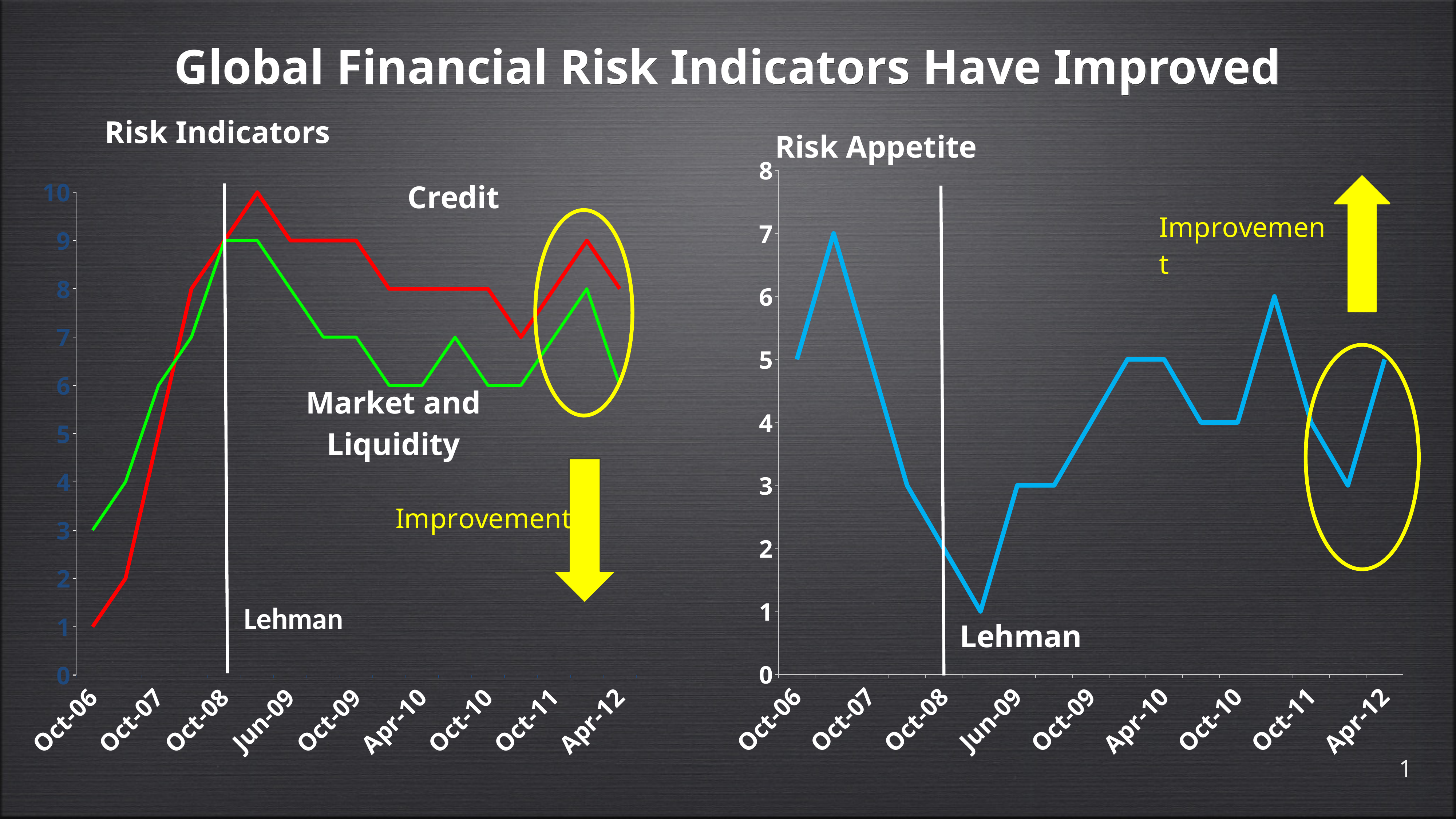
What type of chart is the Risk Appetite chart on the right? line chart In the Risk Indicators chart on the left, what is the highest value reached by the Credit line? 10 In the Risk Appetite chart on the right, what is the value at Oct-08? 2 In the Risk Indicators chart on the left, what are the names of the two plotted series? Credit; Market and Liquidity In the Risk Indicators chart on the left, at Oct-06 which series is higher, Credit or Market and Liquidity? Market and Liquidity In the Risk Appetite chart on the right, what is the lowest value reached by the line? 1 In the Risk Appetite chart on the right, what is the value at Oct-06? 5 In the Risk Indicators chart on the left, how many series are plotted? 2 In the Risk Indicators chart on the left, what is the Credit value at Oct-06? 1 In the Risk Appetite chart on the right, is the value at Apr-12 greater or less than 4? greater In the Risk Indicators chart on the left, what is the Market and Liquidity value at Oct-06? 3 In the Risk Appetite chart on the right, what is the value at Oct-07? 5